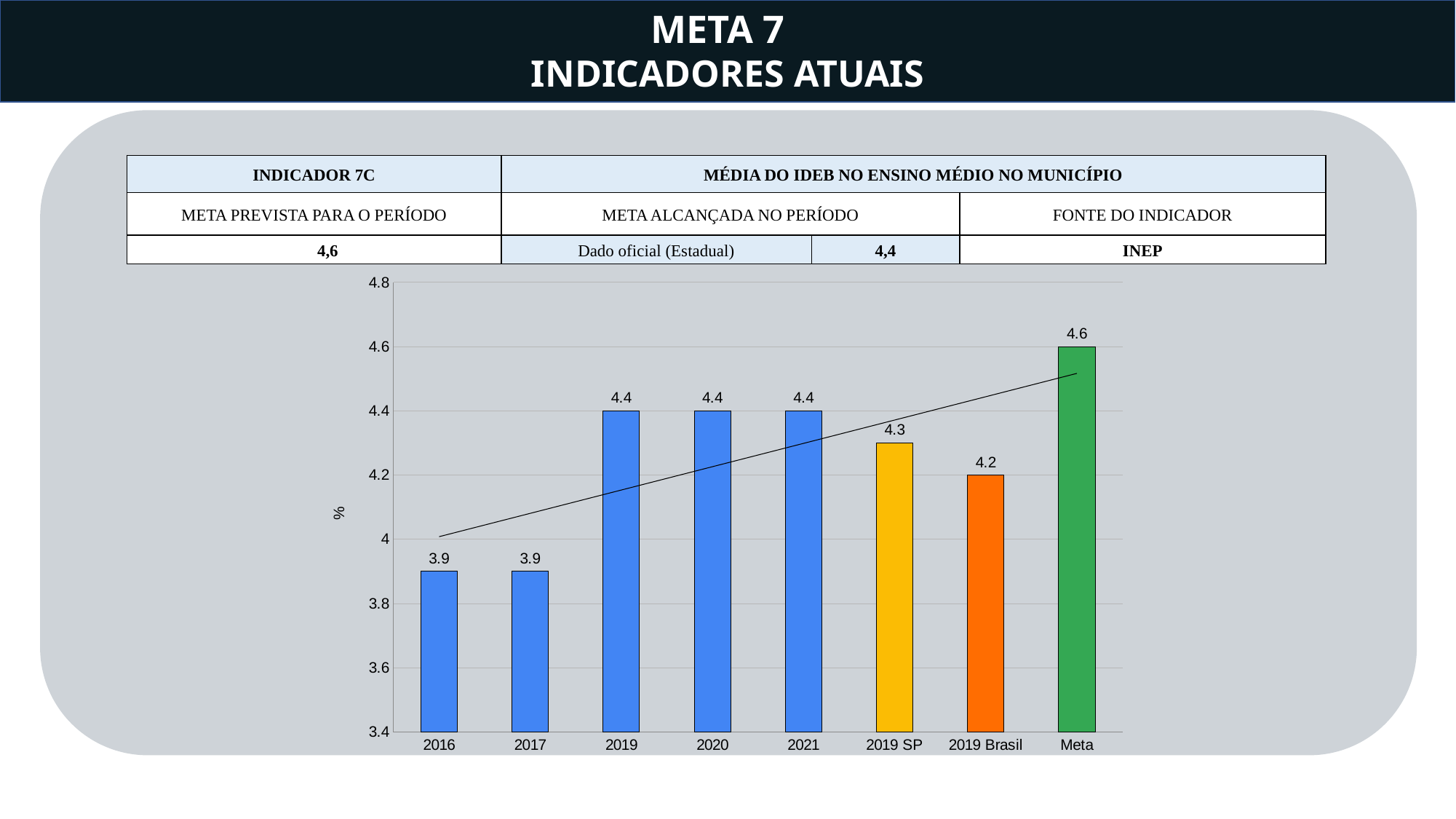
What is the difference between the Meta value and the 2021 value? 0.2 Which category has the highest value? Meta What is the label on the vertical axis of the chart? % What is the value for Meta? 4.6 Is the value for 2017 greater or less than 4? less Which is larger, the value for 2019 SP or the value for 2019 Brasil? 2019 SP What is the value for 2019 Brasil? 4.2 What is the value for 2019 SP? 4.3 How many bars are shown in the chart? 8 What is the value for 2016? 3.9 Do the values rise or fall from 2016 to 2019? rise What kind of chart is shown on the slide? bar chart